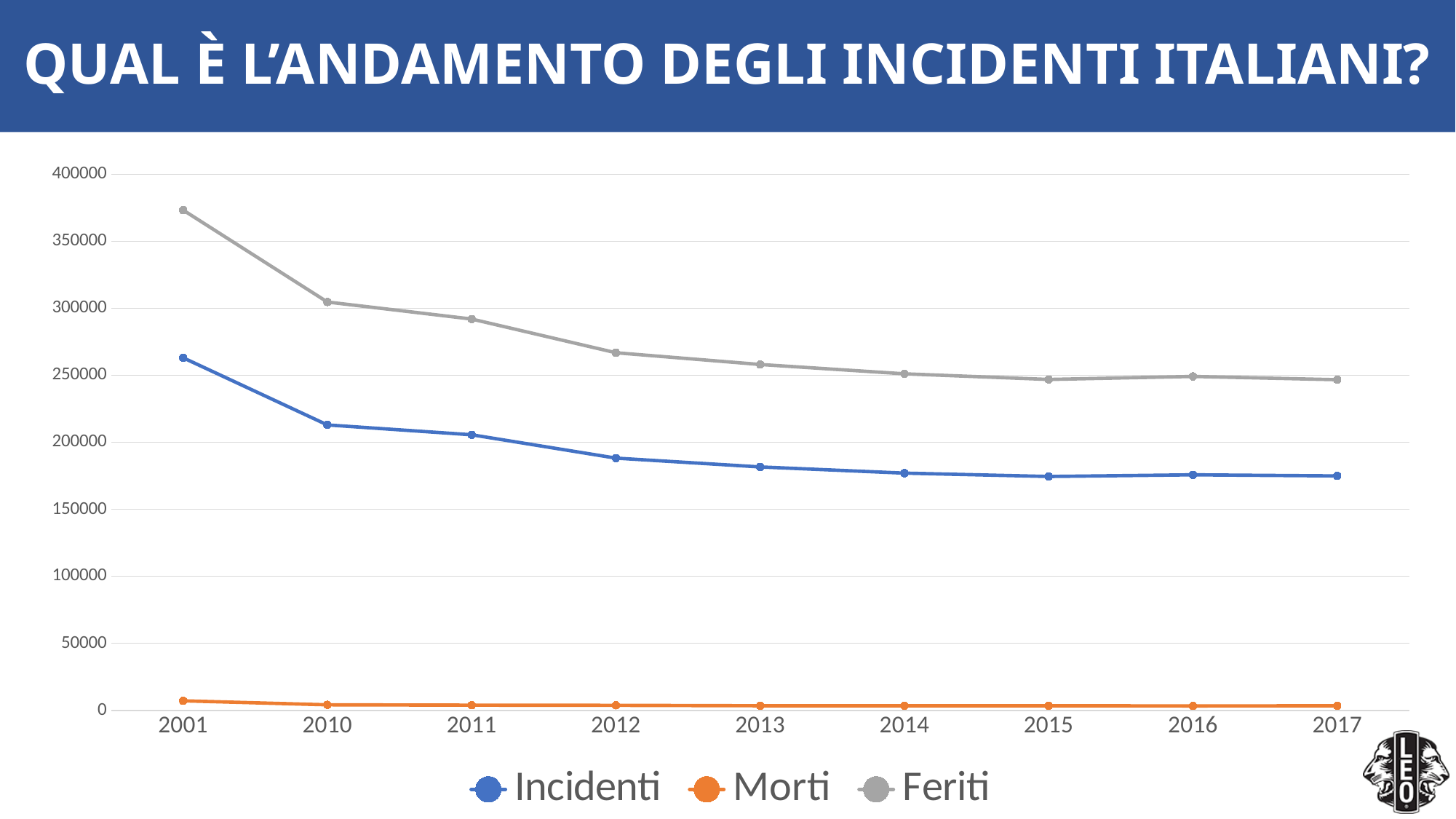
How many series does the legend list? 3 Which series is plotted in orange? Morti Does the Feriti series rise or fall from 2001 to 2017? fall Is the Incidenti value for 2017 greater or less than 200000? less Does the Incidenti series rise or fall from 2001 to 2012? fall Is the Feriti value for 2001 greater or less than 350000? greater In which year is the Feriti value highest? 2001 What kind of chart is shown on the slide? line chart What is the title of the slide containing the chart? QUAL È L'ANDAMENTO DEGLI INCIDENTI ITALIANI? In which year is the Incidenti value highest? 2001 How many years are plotted along the x axis? 9 In 2010, which series has the larger value, Incidenti or Feriti? Feriti